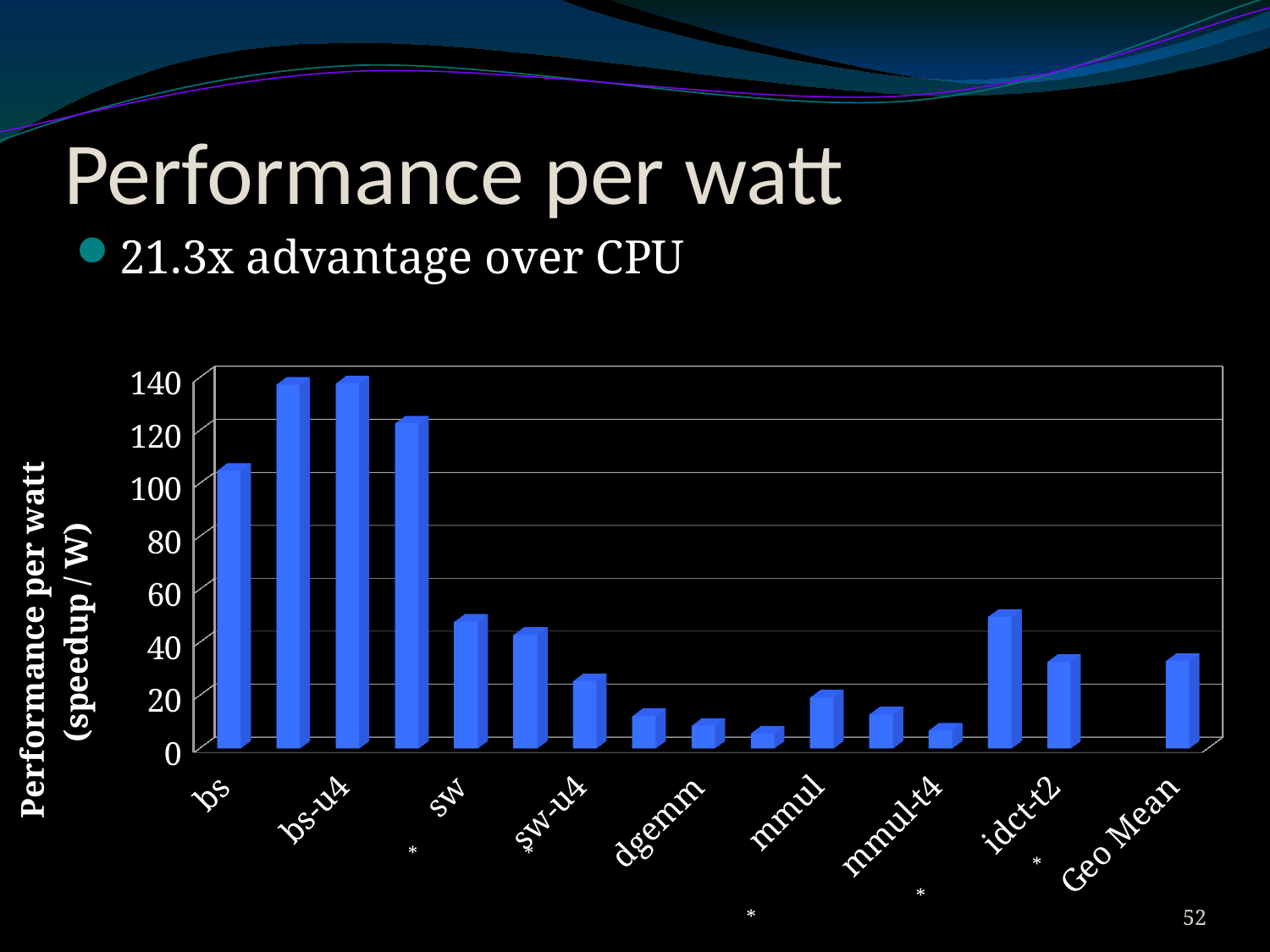
Which has the larger value, bs-u4 or sw? bs-u4 What is the highest tick value shown on the vertical axis? 140 Is the value for Geo Mean greater or less than 40? less Is the value for sw greater or less than 60? less Is the value for bs-u4 greater or less than 100? greater How many category labels are readable on the x axis of the chart? 9 Which has the larger value, bs or Geo Mean? bs What kind of chart is shown on the slide? bar chart Which has the larger value, bs or dgemm? bs What is the label of the vertical axis of the chart? Performance per watt (speedup / W)